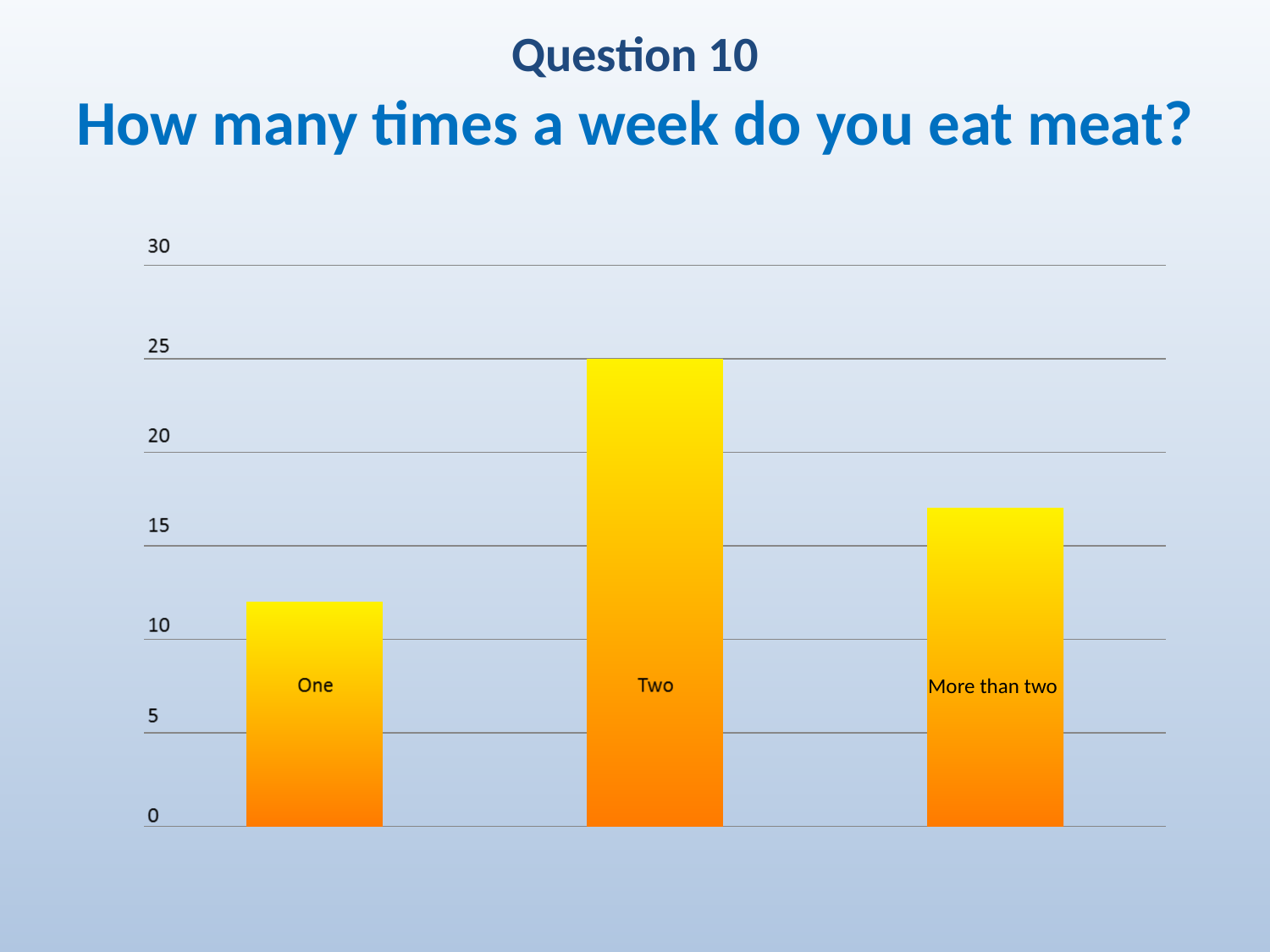
What question does the chart title say the chart is about? How many times a week do you eat meat? Is the value for More than two greater or less than 20? less How many categories are shown in the chart? 3 What kind of chart is shown on the slide? bar chart Is the value for One greater or less than 10? greater Which category has the lowest value? One Is the value for One greater or less than 15? less Which category has the highest value? Two What is the highest value shown on the vertical axis? 30 Which is larger, the value for One or the value for More than two? More than two